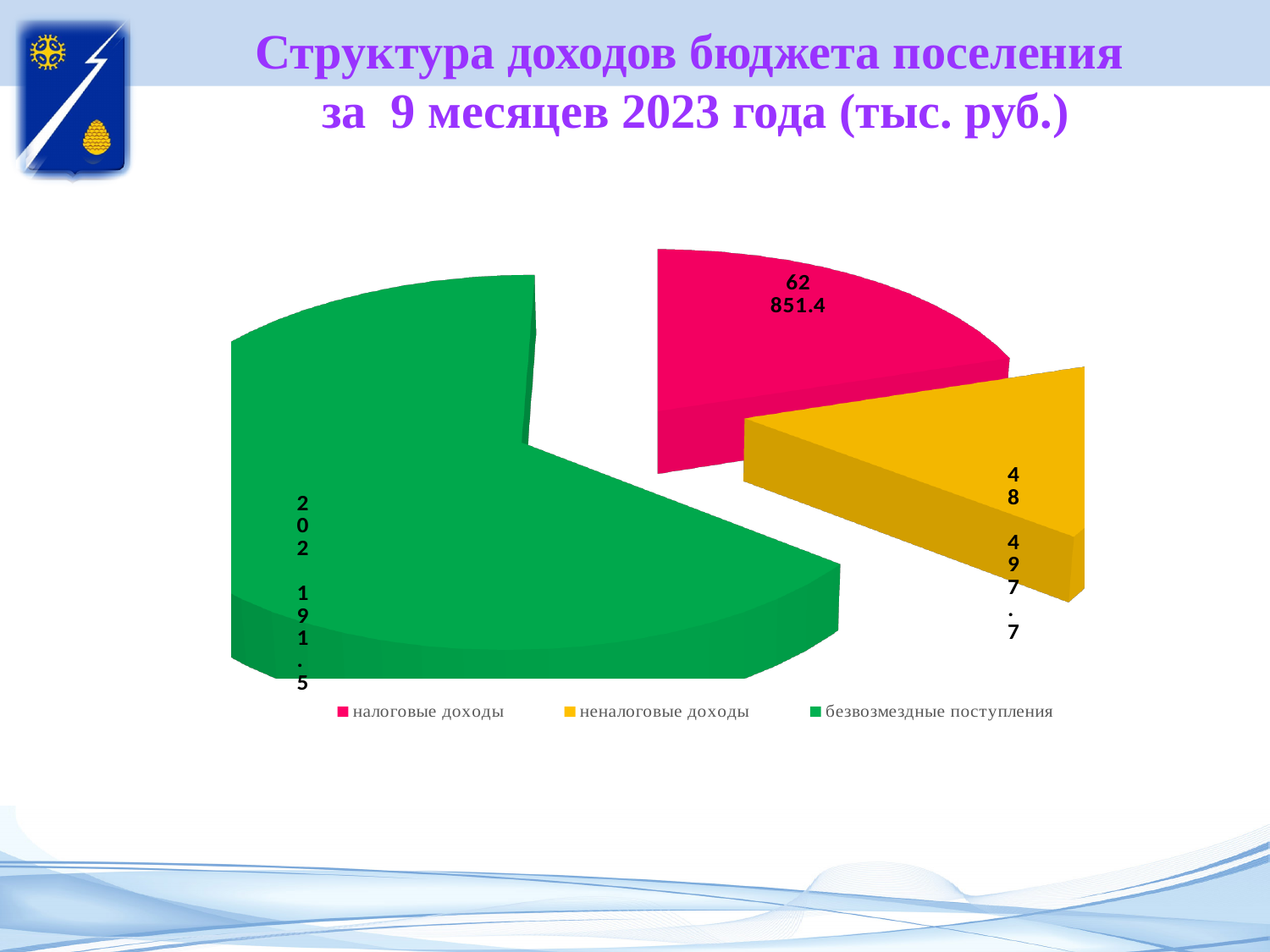
What is the total of all three slices? 313 540.6 What is the value for налоговые доходы? 62 851.4 How many slices does the pie chart have? 3 Which is larger, налоговые доходы or неналоговые доходы? налоговые доходы How many entries does the legend list? 3 Which category has the smallest slice of the pie? неналоговые доходы What is the value for безвозмездные поступления? 202 191.5 Which category has the largest slice of the pie? безвозмездные поступления What is the difference between налоговые доходы and неналоговые доходы? 14 353.7 What is the value for неналоговые доходы? 48 497.7 What kind of chart is shown on the slide? pie chart What is the difference between безвозмездные поступления and налоговые доходы? 139 340.1